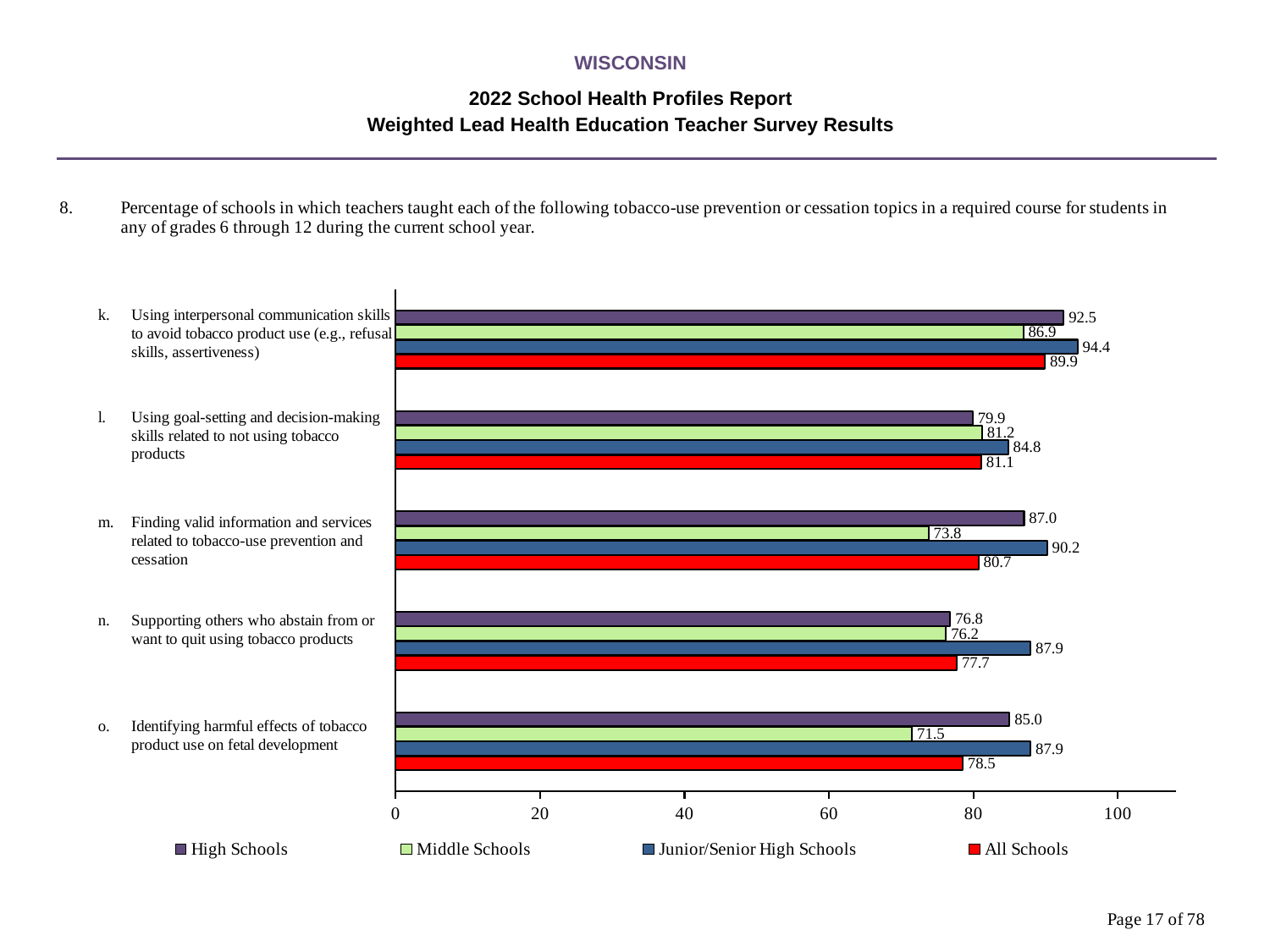
Is the Middle Schools value for topic k, using interpersonal communication skills, greater or less than 80? greater Which school type has the highest value for topic n, supporting others who abstain from or want to quit using tobacco products? Junior/Senior High Schools How many series does the legend list? 4 What kind of chart is shown on the slide? bar chart What is the All Schools value for topic m, finding valid information and services related to tobacco-use prevention and cessation? 80.7 Which colour represents All Schools in the legend? red How many tobacco-use prevention topics are shown on the chart? 5 Which school type has the lowest value for topic m, finding valid information and services related to tobacco-use prevention and cessation? Middle Schools What is the value for Middle Schools for topic o, identifying harmful effects of tobacco product use on fetal development? 71.5 What is the value for Junior/Senior High Schools for topic k, using interpersonal communication skills to avoid tobacco product use? 94.4 For topic l, using goal-setting and decision-making skills, which is larger: the High Schools value or the Junior/Senior High Schools value? Junior/Senior High Schools What is the difference between the High Schools and Middle Schools values for topic o, identifying harmful effects of tobacco product use on fetal development? 13.5